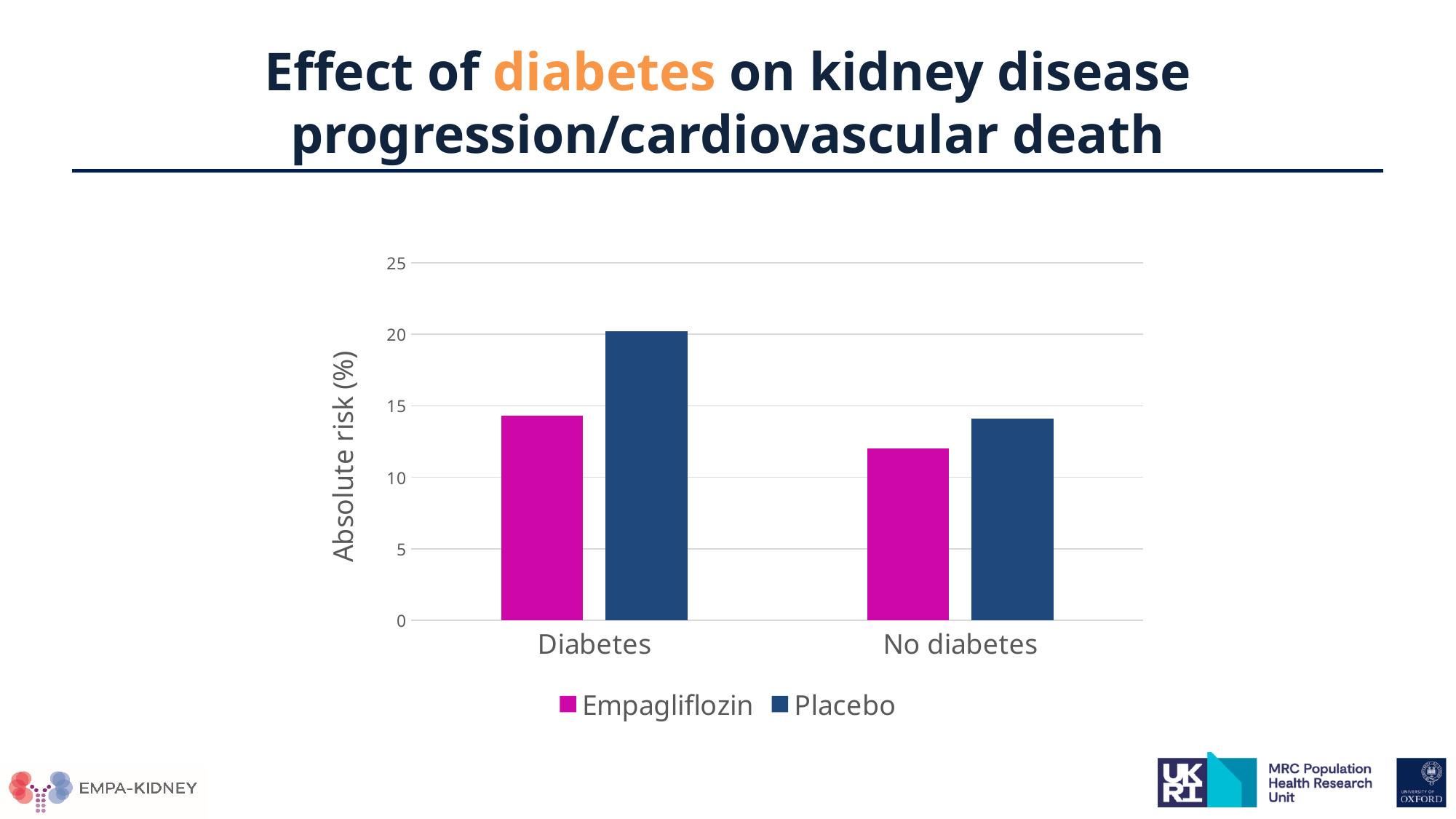
Which bar is the highest in the chart? Placebo, Diabetes What is the label of the y axis? Absolute risk (%) What type of chart is shown on the slide? Bar chart Within the Diabetes group, which is larger: Empagliflozin or Placebo? Placebo Is the Empagliflozin value for Diabetes greater or less than 10? greater Is the Placebo value for No diabetes greater or less than 10? greater Which bar is the lowest in the chart? Empagliflozin, No diabetes Is the Empagliflozin value for No diabetes greater or less than 15? less Which is larger: the Placebo value for Diabetes or the Placebo value for No diabetes? Placebo for Diabetes How many series does the legend list? 2 How many categories are shown on the x axis? 2